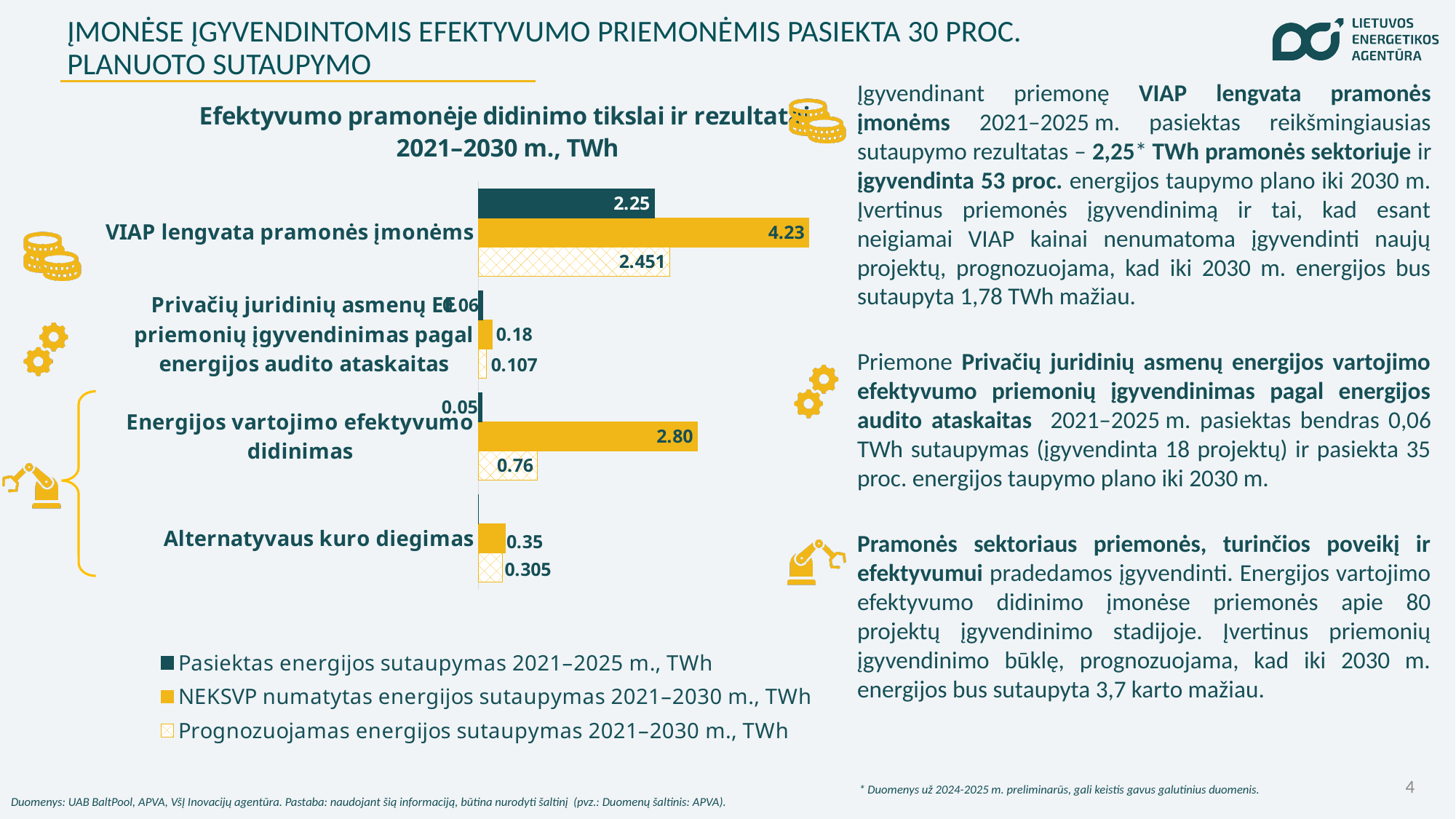
What is the value of 'Prognozuojamas energijos sutaupymas 2021–2030 m., TWh' for 'Alternatyvaus kuro diegimas'? 0.305 What is the value of 'Prognozuojamas energijos sutaupymas 2021–2030 m., TWh' for 'VIAP lengvata pramonės įmonėms'? 2.451 For 'Energijos vartojimo efektyvumo didinimas', which is larger: the 'NEKSVP numatytas' value or the 'Prognozuojamas' value? NEKSVP numatytas energijos sutaupymas 2021–2030 m., TWh Which category has the highest value for 'NEKSVP numatytas energijos sutaupymas 2021–2030 m., TWh'? VIAP lengvata pramonės įmonėms What is the value of 'NEKSVP numatytas energijos sutaupymas 2021–2030 m., TWh' for 'VIAP lengvata pramonės įmonėms'? 4.23 How many series does the chart legend list? 3 What is the difference between the 'NEKSVP numatytas' value and the 'Pasiektas' value for 'VIAP lengvata pramonės įmonėms'? 1.98 What type of chart is shown on the slide? Bar chart What is the value of 'Pasiektas energijos sutaupymas 2021–2025 m., TWh' for 'VIAP lengvata pramonės įmonėms'? 2.25 Which category has the lowest value for 'NEKSVP numatytas energijos sutaupymas 2021–2030 m., TWh'? Privačių juridinių asmenų EE priemonių įgyvendinimas pagal energijos audito ataskaitas What is the value of 'NEKSVP numatytas energijos sutaupymas 2021–2030 m., TWh' for 'Energijos vartojimo efektyvumo didinimas'? 2.80 How many categories are shown in the chart? 4